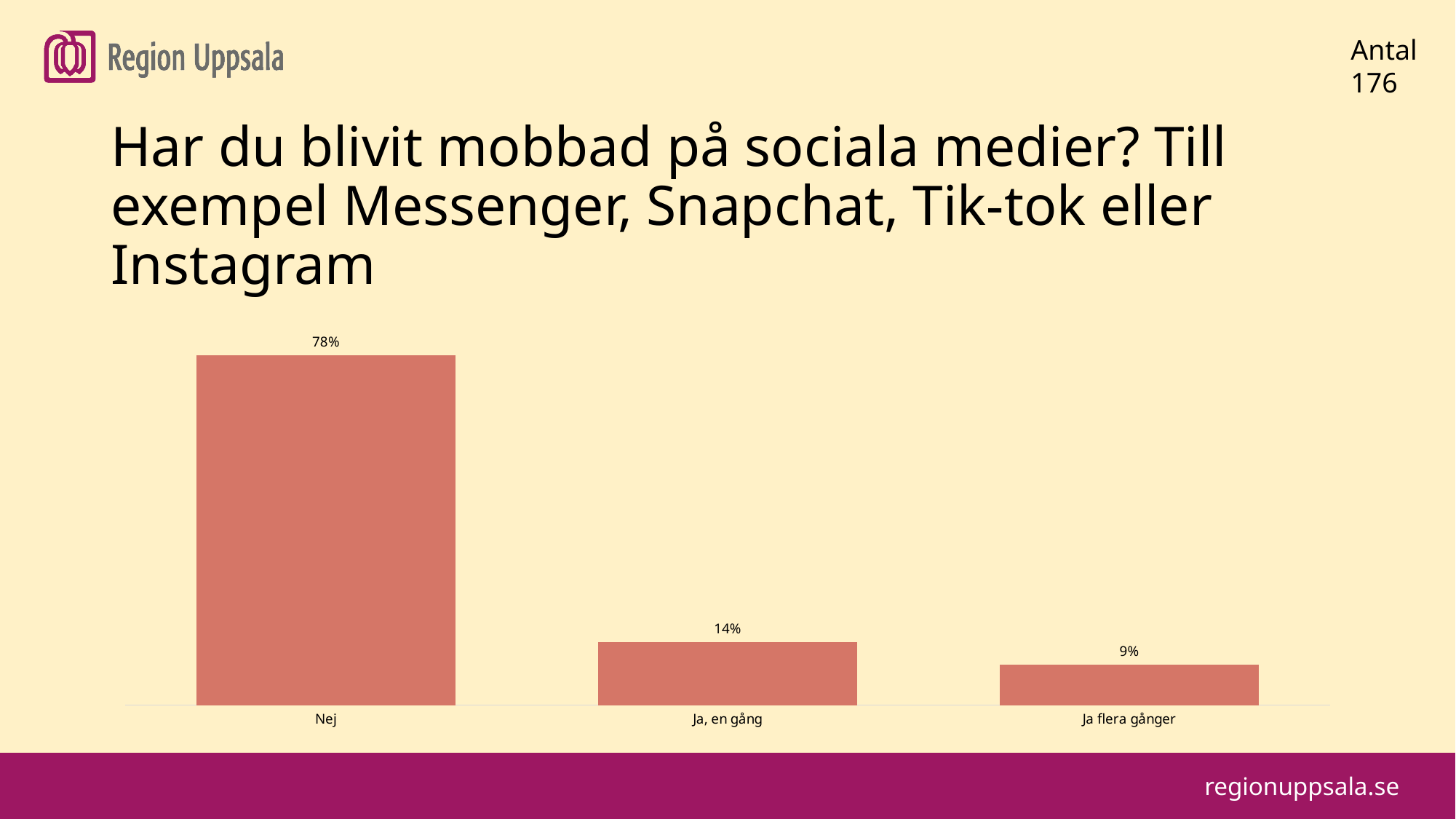
What kind of chart is shown on the slide? Bar chart Do the values rise or fall from left to right across the categories? Fall What is the difference between the values for "Ja, en gång" and "Ja flera gånger"? 5% What is the value for "Ja flera gånger"? 9% What is the value for "Nej"? 78% Which category has the lowest value? Ja flera gånger What is the difference between the values for "Nej" and "Ja, en gång"? 64% Which is larger, the value for "Ja, en gång" or the value for "Ja flera gånger"? Ja, en gång What is the number of respondents (Antal) shown on the slide? 176 Which category has the highest value? Nej What is the value for "Ja, en gång"? 14% How many categories are shown in the chart? 3